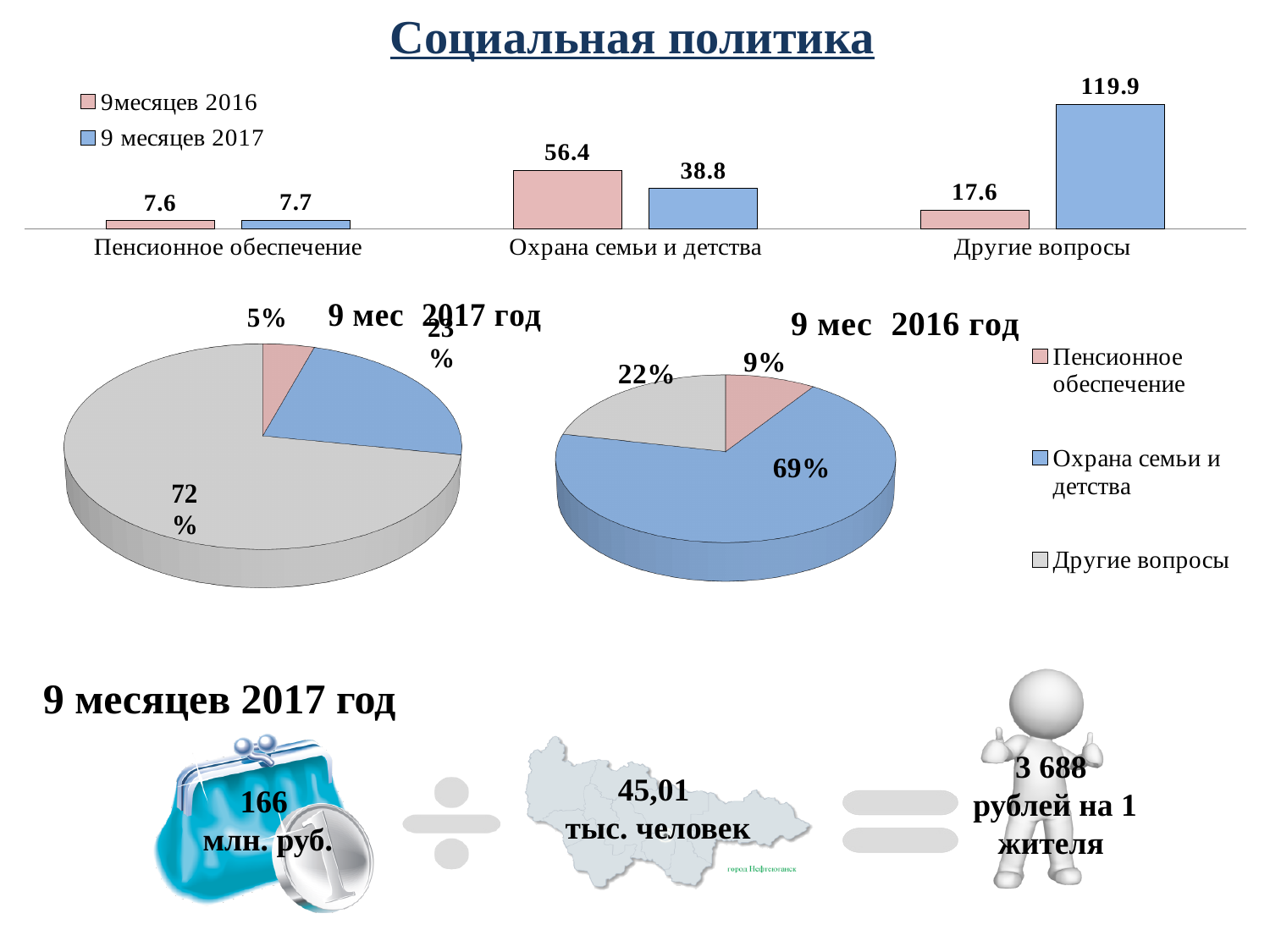
How many series does the legend of the bar chart at the top of the slide list? 2 In the bar chart at the top of the slide, what is the difference between the 9 месяцев 2017 and 9месяцев 2016 values for Другие вопросы? 102.3 What kind of chart is the chart at the top of the slide? Bar chart In the bar chart at the top of the slide, which category has the lowest value for 9месяцев 2016? Пенсионное обеспечение In the bar chart at the top of the slide, which category has the highest value for 9 месяцев 2017? Другие вопросы In the pie chart titled 9 мес 2016 год, what share does Охрана семьи и детства have? 69% How many categories are shown in the bar chart at the top of the slide? 3 In the pie chart titled 9 мес 2016 год, which category has the smallest slice? Пенсионное обеспечение In the bar chart at the top of the slide, what is the value for Другие вопросы for 9месяцев 2016? 17.6 In the bar chart at the top of the slide, what is the value for Охрана семьи и детства for 9 месяцев 2017? 38.8 In the bar chart at the top of the slide, which is larger for Охрана семьи и детства: the 9месяцев 2016 value or the 9 месяцев 2017 value? 9месяцев 2016 In the pie chart titled 9 мес 2017 год, what share does Другие вопросы have? 72%